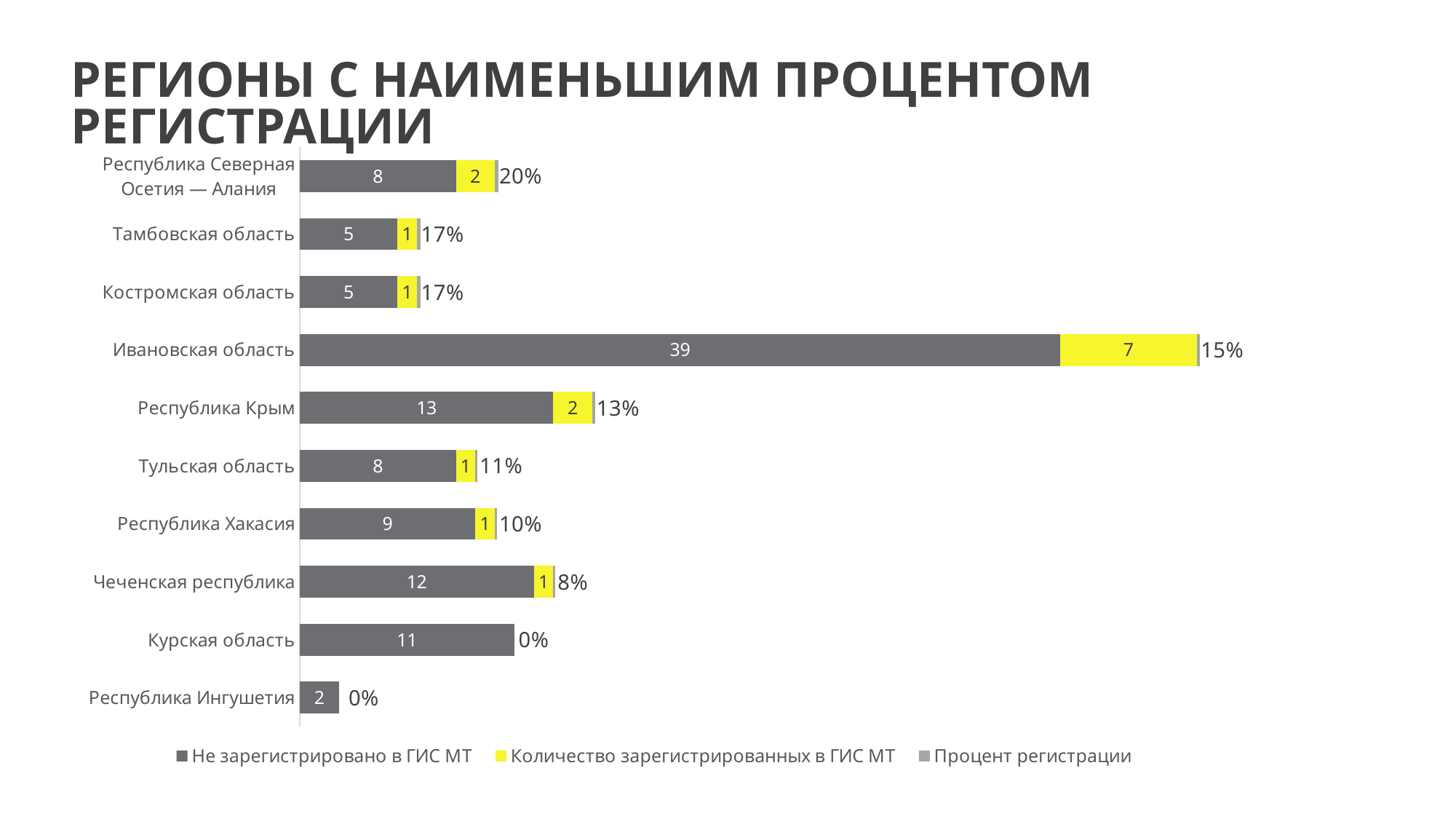
What is the 'Процент регистрации' for Чеченская республика? 8% What is the value of 'Не зарегистрировано в ГИС МТ' for Ивановская область? 39 How many series does the legend list? 3 What type of chart is shown on the slide? Stacked bar chart What is the value of 'Количество зарегистрированных в ГИС МТ' for Республика Северная Осетия — Алания? 2 What is the total of the 'Не зарегистрировано в ГИС МТ' and 'Количество зарегистрированных в ГИС МТ' values for Республика Крым? 15 Which region has the lowest value of 'Не зарегистрировано в ГИС МТ'? Республика Ингушетия How many regions are listed on the chart? 10 Which region has the highest value of 'Не зарегистрировано в ГИС МТ'? Ивановская область Which colour represents 'Количество зарегистрированных в ГИС МТ' in the legend? Yellow What is the difference between the 'Не зарегистрировано в ГИС МТ' values for Ивановская область and Республика Крым? 26 Which region has a larger 'Не зарегистрировано в ГИС МТ' value, Чеченская республика or Курская область? Чеченская республика